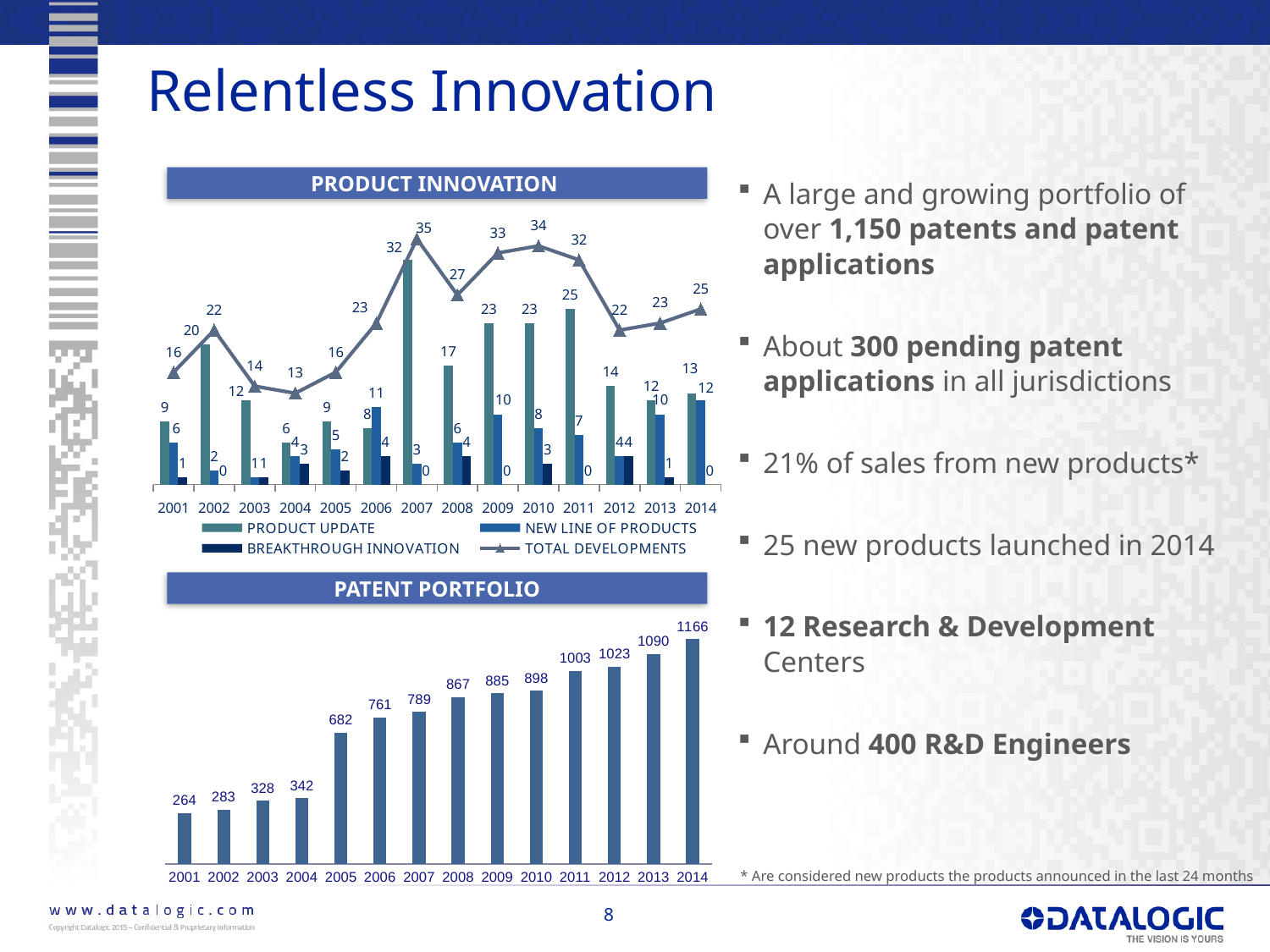
What kind of chart is the PATENT PORTFOLIO chart? Bar chart In the PRODUCT INNOVATION chart, which year has the highest TOTAL DEVELOPMENTS value? 2007 In the PATENT PORTFOLIO chart, what is the value for 2001? 264 In the PRODUCT INNOVATION chart, what is the TOTAL DEVELOPMENTS value for 2007? 35 In the PATENT PORTFOLIO chart, do the values rise or fall from 2001 to 2014? Rise In the PRODUCT INNOVATION chart, what is the PRODUCT UPDATE value for 2002? 20 In the PATENT PORTFOLIO chart, how many years are shown on the x axis? 14 How many series does the legend of the PRODUCT INNOVATION chart list? 4 In the PATENT PORTFOLIO chart, what is the difference between the 2014 and 2013 values? 76 In the PATENT PORTFOLIO chart, which year has the lowest value? 2001 In the PATENT PORTFOLIO chart, what is the value for 2014? 1166 In the PATENT PORTFOLIO chart, which year has the highest value? 2014